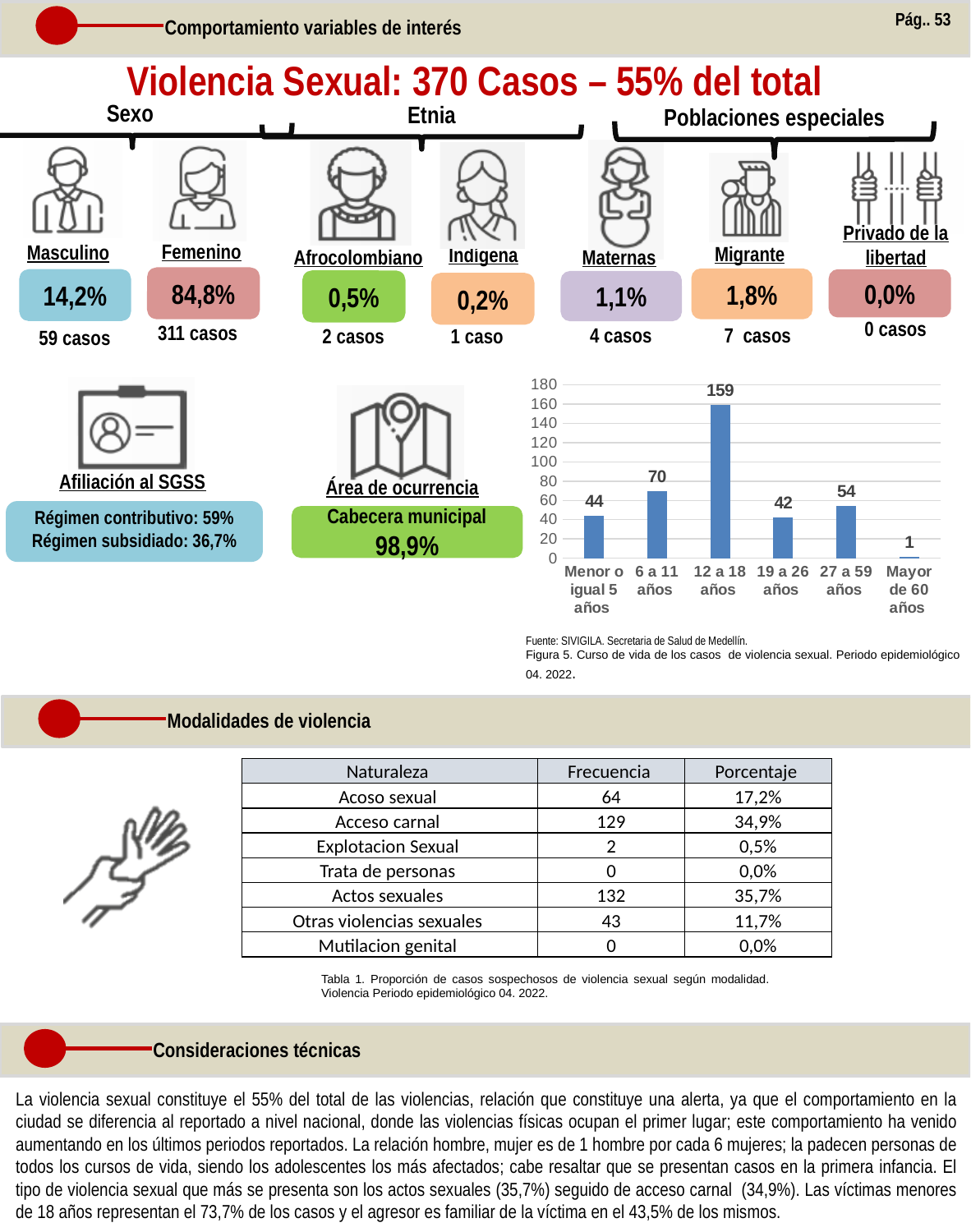
In the bar chart of cases by life course, what is the highest value shown on the vertical axis? 180 How many age groups are shown on the x axis of the bar chart of cases by life course? 6 In the bar chart of cases by life course, which age group has the lowest number of cases? Mayor de 60 años In the bar chart of cases by life course, how many cases are shown for the 'Menor o igual 5 años' group? 44 In the bar chart of cases by life course, how many cases are shown for the '12 a 18 años' group? 159 In the bar chart of cases by life course, is the value for '6 a 11 años' greater or less than 60? greater In the bar chart of cases by life course, how many cases are shown for the 'Mayor de 60 años' group? 1 In the bar chart of cases by life course, which age group has the highest number of cases? 12 a 18 años In the bar chart of cases by life course, what is the difference in cases between the '12 a 18 años' group and the '6 a 11 años' group? 89 In the bar chart of cases by life course, how many cases are shown for the '27 a 59 años' group? 54 What type of chart is used to show the cases of sexual violence by life course (Figura 5)? bar chart In the bar chart of cases by life course, which group has more cases: '19 a 26 años' or '27 a 59 años'? 27 a 59 años